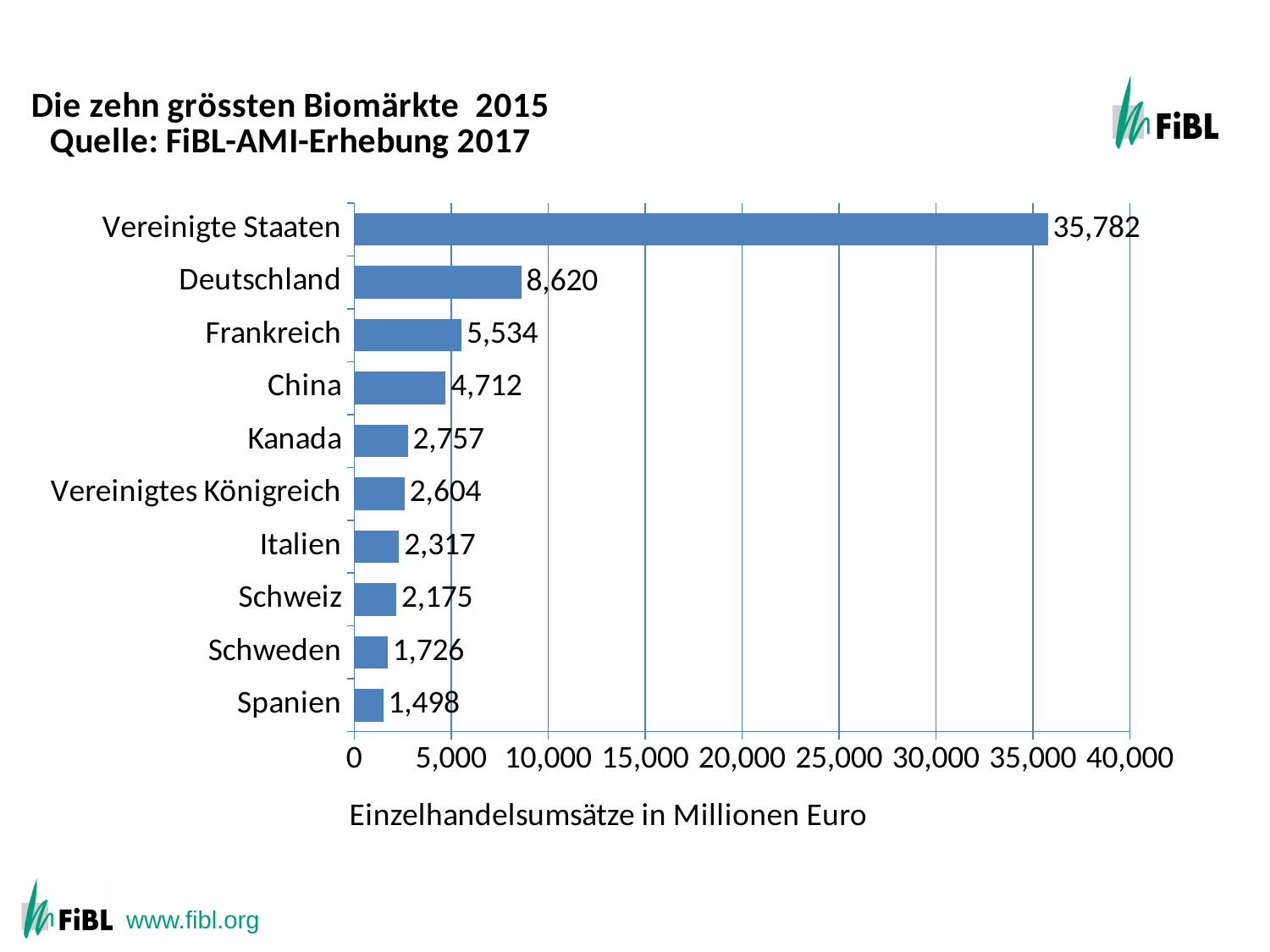
What is the value for China? 4,712 Which country has the lowest value? Spanien How many countries are shown in the chart? 10 What is the value for Schweiz? 2,175 Which is larger, the value for Kanada or the value for Italien? Kanada What is the label of the horizontal axis? Einzelhandelsumsätze in Millionen Euro What is the difference between the values for Frankreich and China? 822 Which country has the highest value? Vereinigte Staaten Is the value for Frankreich greater or less than 5,000? greater What is the value for Deutschland? 8,620 What kind of chart is shown on the slide? bar chart What is the difference between the values for Vereinigte Staaten and Deutschland? 27,162